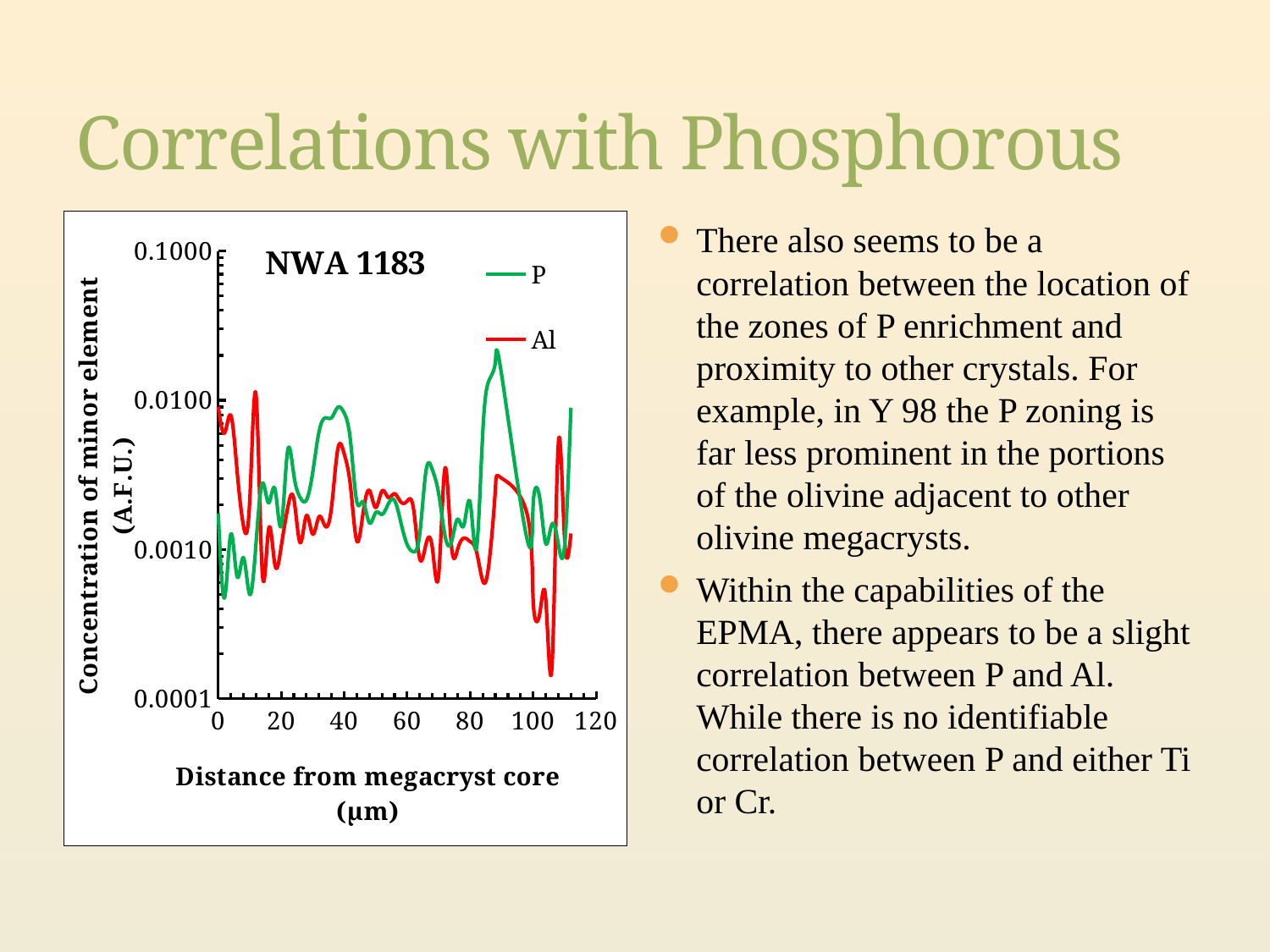
Is the lowest value of Al, near 105 µm, greater or less than 0.0010? less Near 88 µm, which series has the higher concentration, P or Al? P What are the two series named in the legend of the NWA 1183 chart? P and Al Which series reaches the lowest concentration anywhere on the NWA 1183 chart? Al Is the value of P at 0 µm greater or less than 0.0010? greater Is the peak value of P near 88 µm greater or less than 0.0100? greater What kind of chart is shown on the slide? line chart Which series reaches the highest concentration anywhere on the NWA 1183 chart? P How many series does the legend of the NWA 1183 chart list? 2 What colour is the P line in the NWA 1183 chart? green At 0 µm, which series has the higher concentration, P or Al? Al